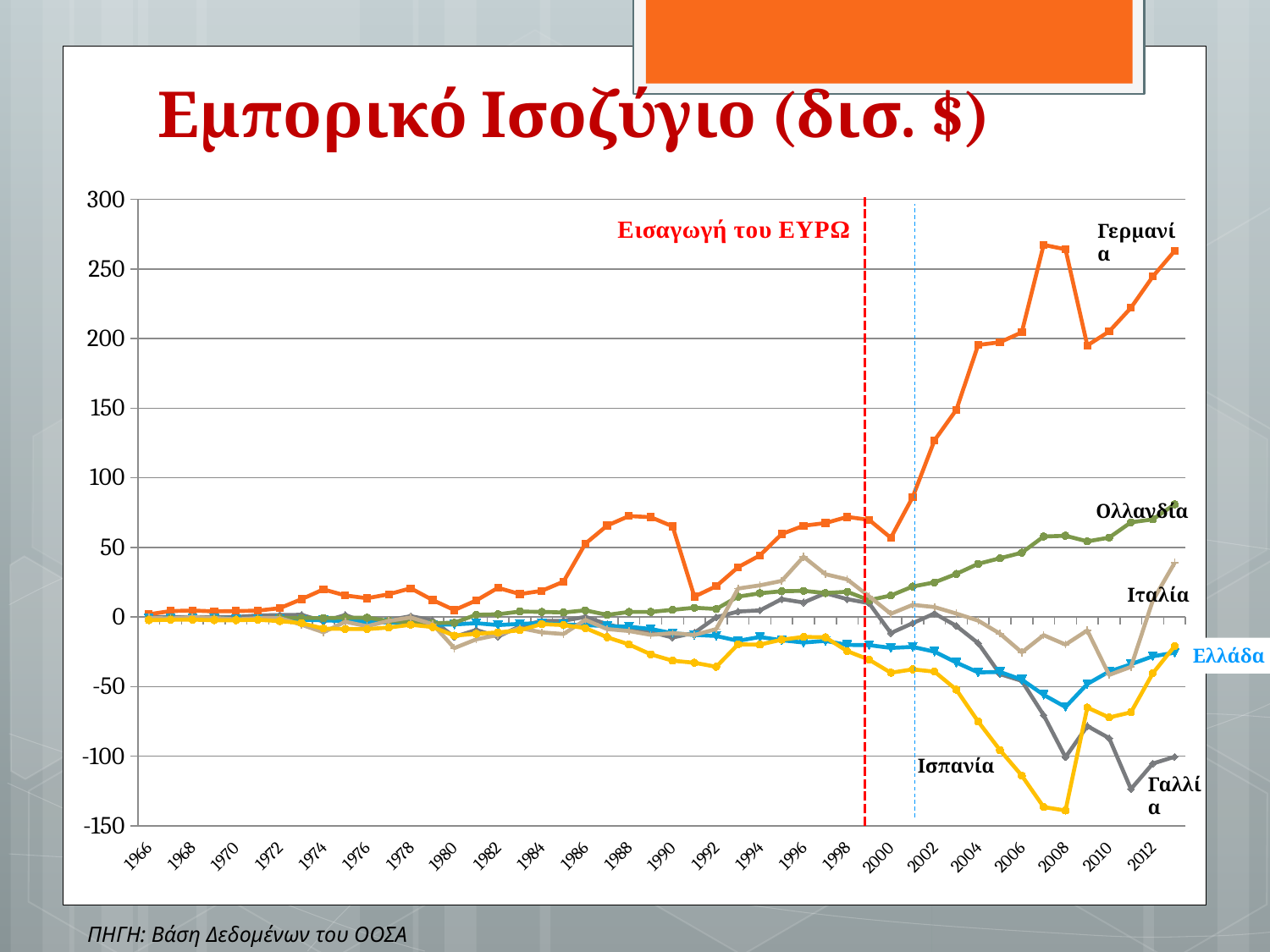
What kind of chart is shown on the slide? line chart Does the trade balance of Γερμανία generally rise or fall between 2000 and 2012? rise What event does the red dashed vertical line mark? Εισαγωγή του ΕΥΡΩ In 2012, which is larger: the value for Ολλανδία or the value for Ιταλία? Ολλανδία Is the value for Γαλλία in 2010 greater or less than -100? greater Is the value for Ολλανδία in 2012 greater or less than 50? greater Is the value for Ισπανία in 2008 greater or less than -100? less What is the title of the chart? Εμπορικό Ισοζύγιο (δισ. $) How many countries are plotted as lines on the chart? 6 Which country has the highest trade balance in 2012? Γερμανία Which country has the lowest trade balance in 2008? Ισπανία